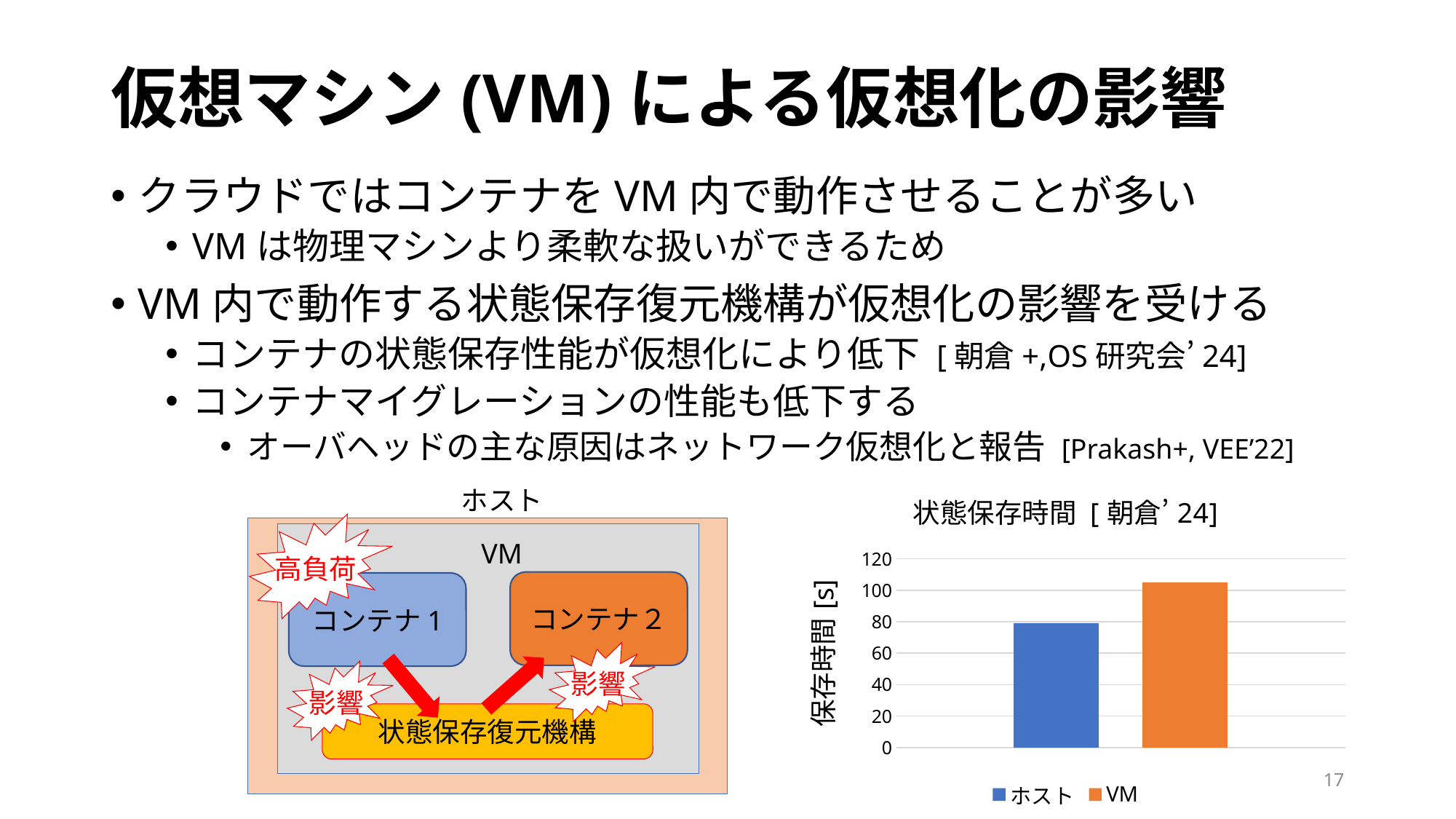
Is the value for ホスト greater or less than 100? less Is the value for ホスト larger or smaller than the value for VM? smaller Is the value for VM greater or less than 120? less How many bars are plotted in the chart? 2 Is the value for VM greater or less than 80? greater Which bar is lowest in the chart? ホスト How many series does the chart legend list? 2 Which bar is highest in the chart, ホスト or VM? VM What kind of chart is shown on the slide? bar chart What is the title of the chart? 状態保存時間 [朝倉'24] What is the label of the vertical axis of the chart? 保存時間 [s]